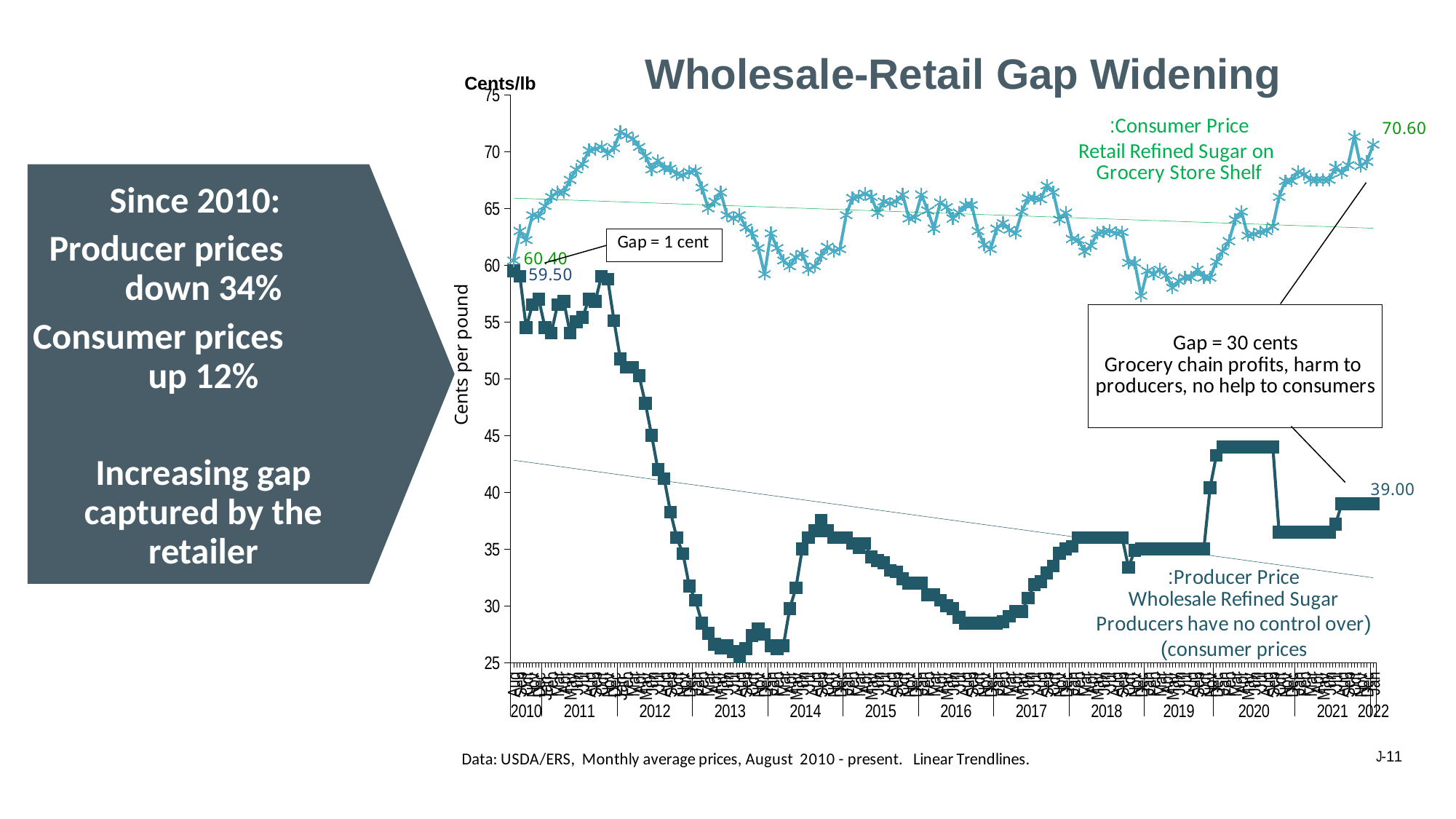
By how much did the labelled Producer Price fall from its 2010 value (59.50) to its 2022 value (39.00)? 20.50 What is the chart's title? Wholesale-Retail Gap Widening Does the Producer Price series overall rise or fall from 2010 to 2022? fall What type of chart is shown on the slide? line chart What is the labelled Consumer Price value at the start of the series in 2010? 60.40 By how much did the labelled Consumer Price rise from its 2010 value (60.40) to its 2022 value (70.60)? 10.20 At the end of the series in 2022, which is higher: the Consumer Price or the Producer Price? Consumer Price How many data series are plotted on the chart? 2 What is the labelled Producer Price value at the start of the series in 2010? 59.50 What is the labelled Producer Price value at the end of the series in 2022? 39.00 Is the Producer Price during 2013 greater or less than 30 cents per pound? less What is the labelled Consumer Price value at the end of the series in 2022? 70.60